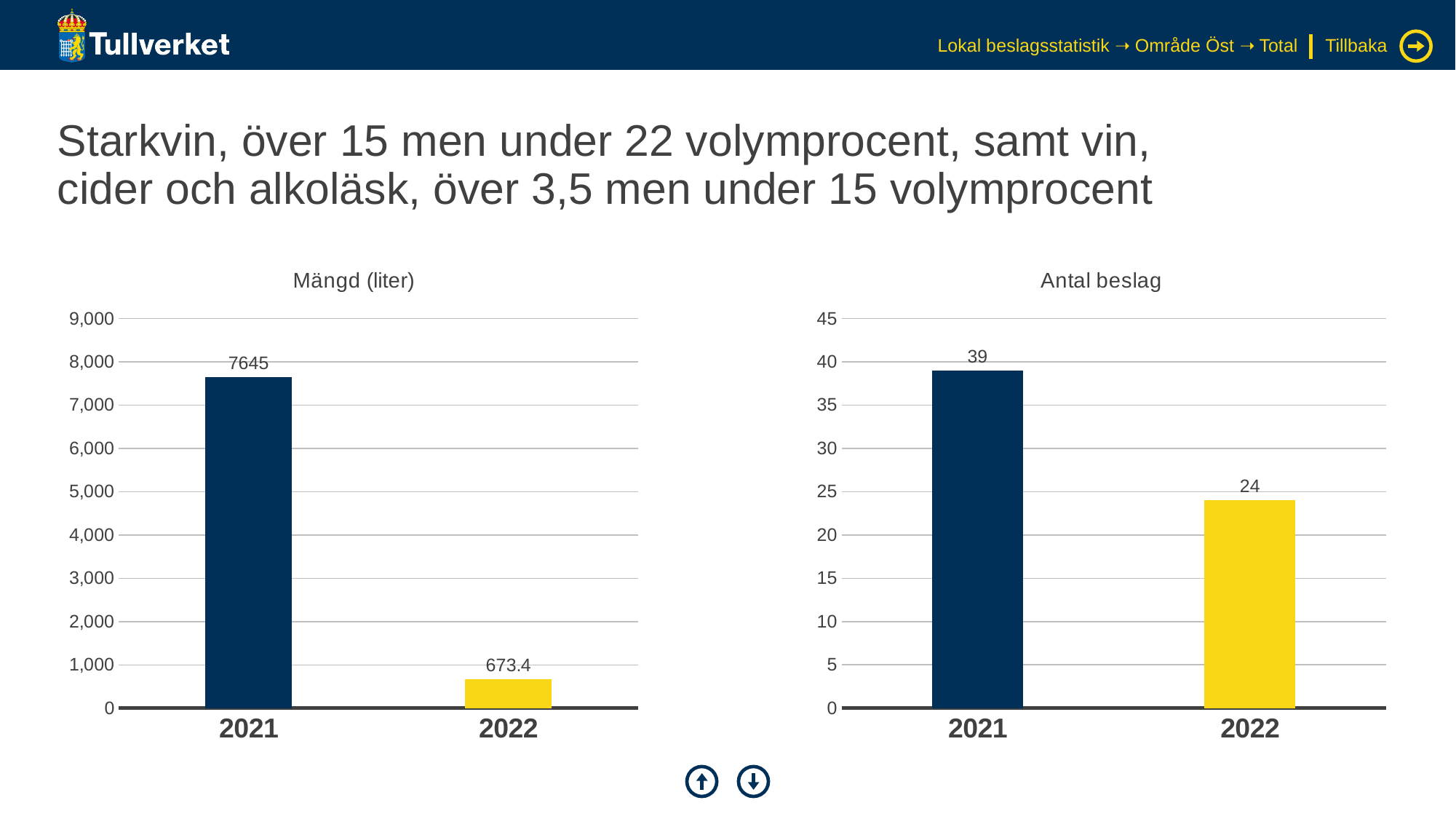
In the 'Antal beslag' chart, which year has the highest value? 2021 In the 'Antal beslag' chart, what is the value for 2022? 24 In the 'Mängd (liter)' chart, what is the value for 2021? 7645 What kind of chart is the 'Mängd (liter)' chart? bar chart In the 'Mängd (liter)' chart, what is the value for 2022? 673.4 In the 'Mängd (liter)' chart, what is the difference between the 2021 and 2022 values? 6971.6 In the 'Antal beslag' chart, how many years are shown on the x axis? 2 In the 'Antal beslag' chart, do the values rise or fall from 2021 to 2022? fall In the 'Antal beslag' chart, what is the difference between the 2021 and 2022 values? 15 In the 'Mängd (liter)' chart, is the value for 2021 greater or less than 7,000? greater In the 'Antal beslag' chart, what is the value for 2021? 39 In the 'Mängd (liter)' chart, which year has the lowest value? 2022